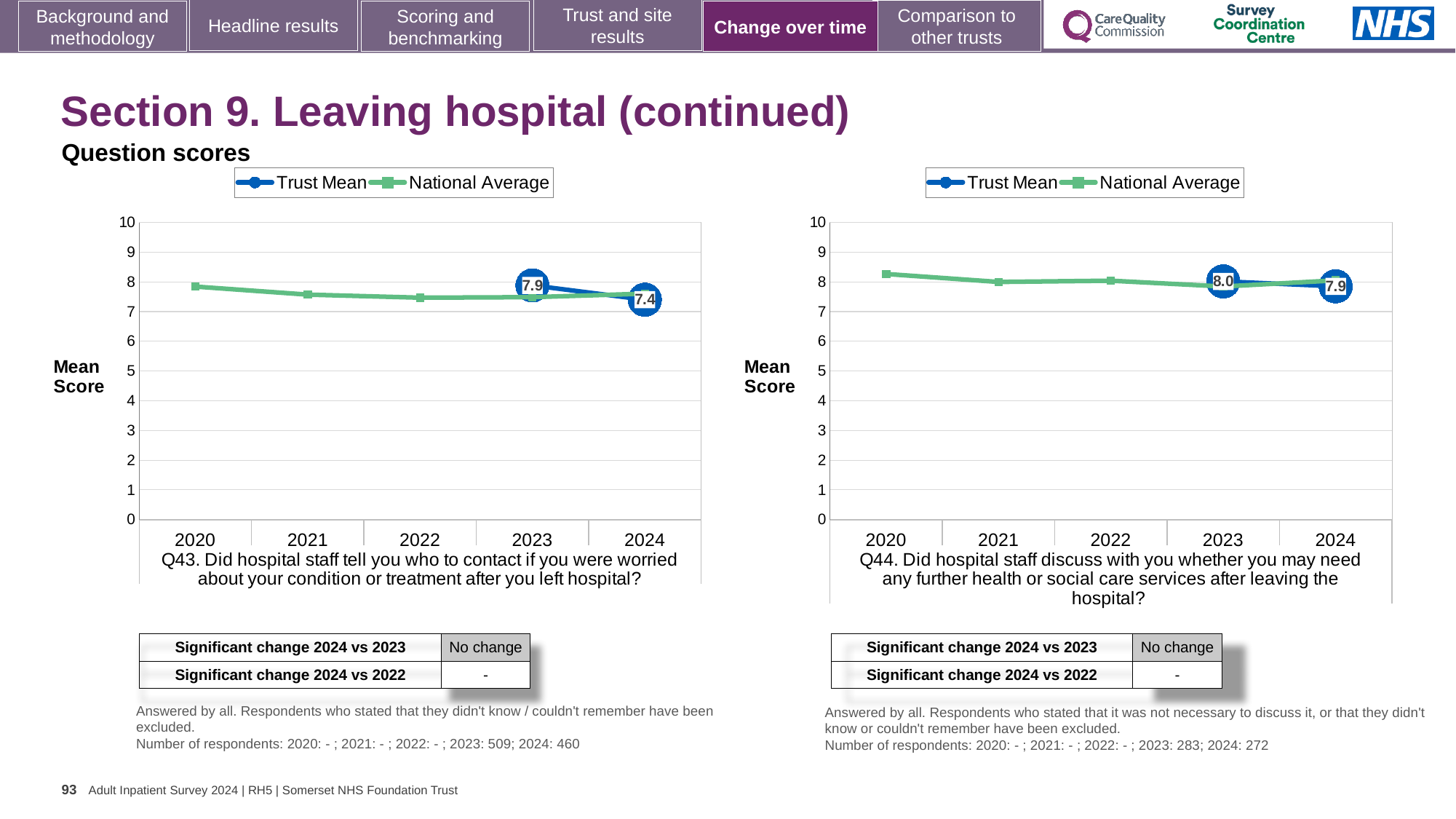
In the Q43 chart on the left, by how much did the Trust Mean fall from 2023 to 2024? 0.5 In the Q43 chart on the left, does the Trust Mean rise or fall from 2023 to 2024? fall In the Q43 chart on the left, is the National Average for 2020 greater or less than 7? greater In the Q43 chart on the left, what is the Trust Mean score for 2024? 7.4 In the Q44 chart on the right, what is the Trust Mean score for 2023? 8.0 In the Q43 chart on the left, what is the Trust Mean score for 2023? 7.9 In the Q44 chart on the right, what is the Trust Mean score for 2024? 7.9 In the Q44 chart on the right, what is the difference between the Trust Mean in 2023 and in 2024? 0.1 How many years are shown on the x axis of the Q44 chart on the right? 5 In the Q43 chart on the left, which year has the higher Trust Mean, 2023 or 2024? 2023 In the Q44 chart on the right, is the National Average for 2021 greater or less than 9? less How many series does the legend of the Q43 chart on the left list? 2